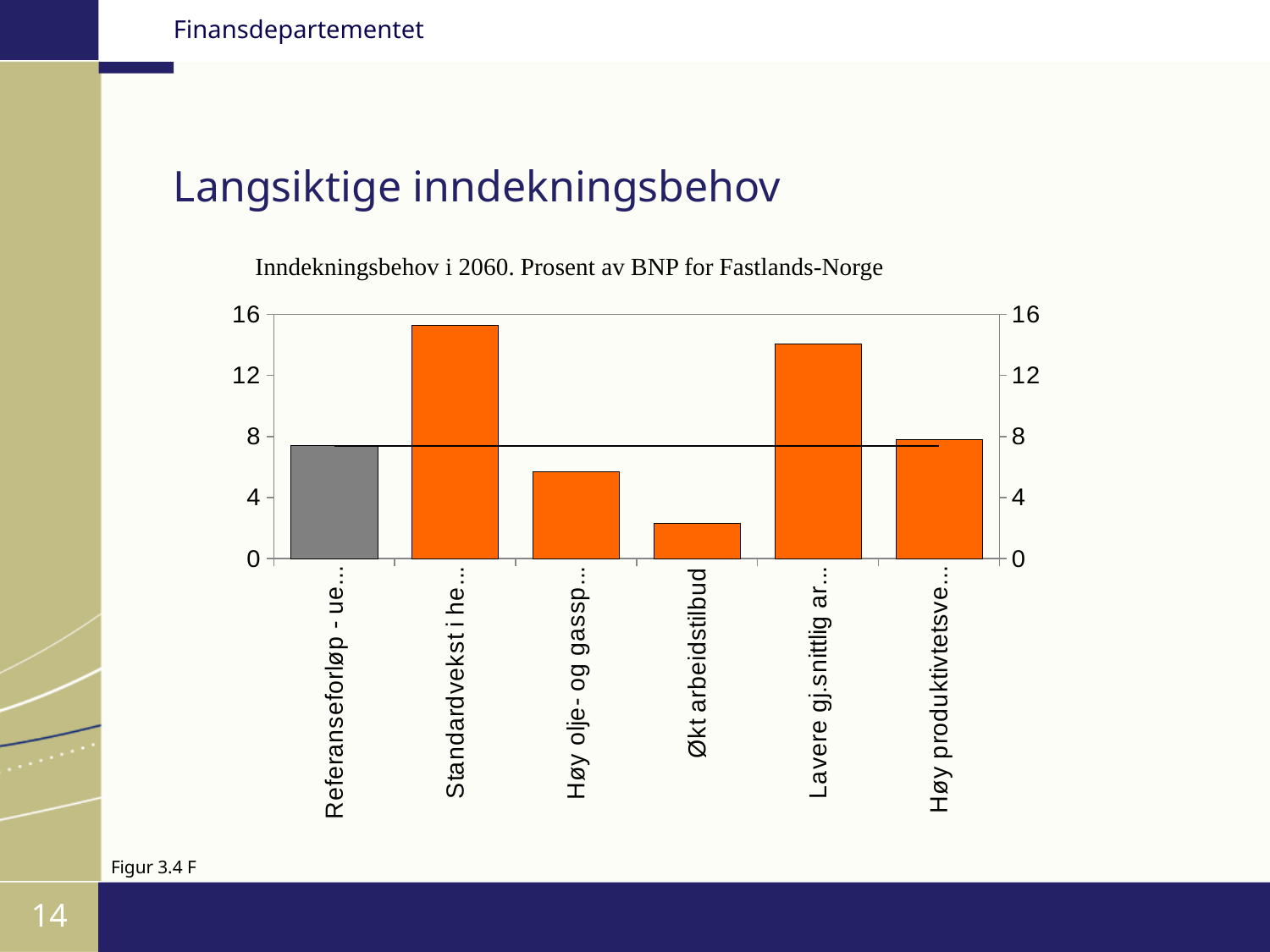
Is the value for Økt arbeidstilbud greater or less than 4? less Is the value for the bar labelled 'Høy olje- og gassp...' greater or less than 4? greater How many bars (categories) are plotted in the chart? 6 What kind of chart is shown on the slide? bar chart Is the value for the bar labelled 'Høy olje- og gassp...' greater or less than 8? less Which category has the lowest bar? Økt arbeidstilbud Which is larger, the value for Økt arbeidstilbud or the value for the bar labelled 'Høy olje- og gassp...'? Høy olje- og gassp... Which category has the highest bar? Standardvekst i he... What colour is the first bar (Referanseforløp) compared with the other bars? grey (the others are orange) What is the title printed above the chart? Inndekningsbehov i 2060. Prosent av BNP for Fastlands-Norge